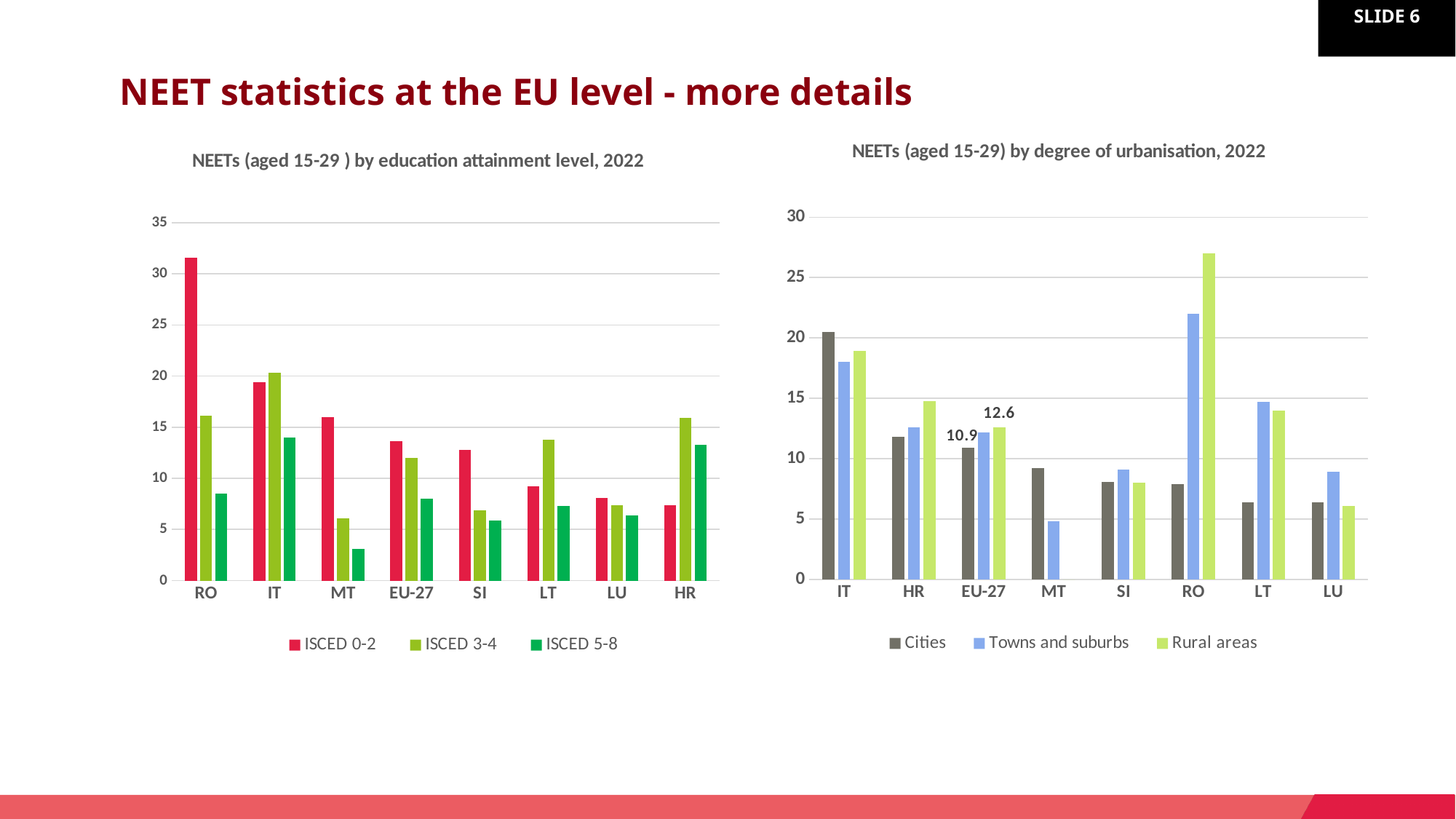
In the left chart on education attainment level, how many countries/regions are shown on the x axis? 8 In the right chart on degree of urbanisation, what is the value for Cities for EU-27? 10.9 In the right chart on degree of urbanisation, which category has the highest Rural areas value? RO In the right chart on degree of urbanisation, what is the difference between the Rural areas and Cities values for EU-27? 1.7 In the left chart on education attainment level, which category has the highest ISCED 0-2 value? RO In the right chart on degree of urbanisation, what is the value for Rural areas for EU-27? 12.6 In the left chart on education attainment level, is the ISCED 0-2 value for RO greater or less than 30? greater In the left chart on education attainment level, which category has the lowest ISCED 5-8 value? MT In the right chart on degree of urbanisation, what are the three legend entries? Cities, Towns and suburbs, Rural areas What type of chart is the left chart, 'NEETs (aged 15-29 ) by education attainment level, 2022'? Bar chart In the left chart on education attainment level, for MT, which is larger: ISCED 0-2 or ISCED 3-4? ISCED 0-2 In the left chart on education attainment level, how many series does the legend list? 3